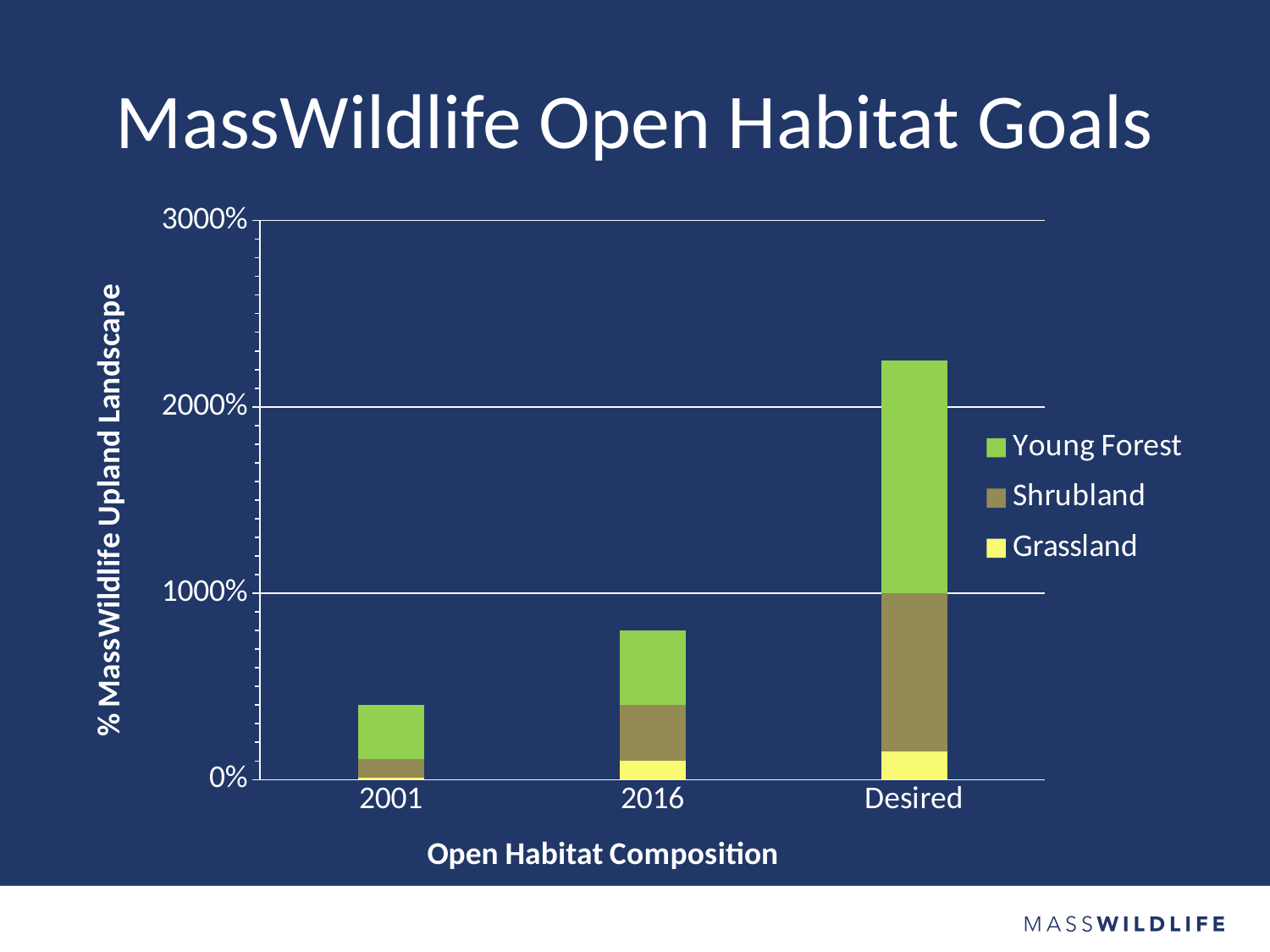
How many series does the legend list? 3 Is the total of the 2016 bar greater or less than 1000%? less Which category has the tallest stacked bar? Desired Is the total of the Desired bar greater or less than 2000%? greater Do the stacked bar totals rise or fall from 2001 to Desired? Rise Is the total of the 2001 bar greater or less than 1000%? less Which category has the shortest stacked bar? 2001 Which series is shown in yellow in the legend? Grassland How many categories are shown on the x axis? 3 What is the title of the chart? MassWildlife Open Habitat Goals Which bar is taller, 2016 or 2001? 2016 What kind of chart is shown on the slide? Stacked bar chart